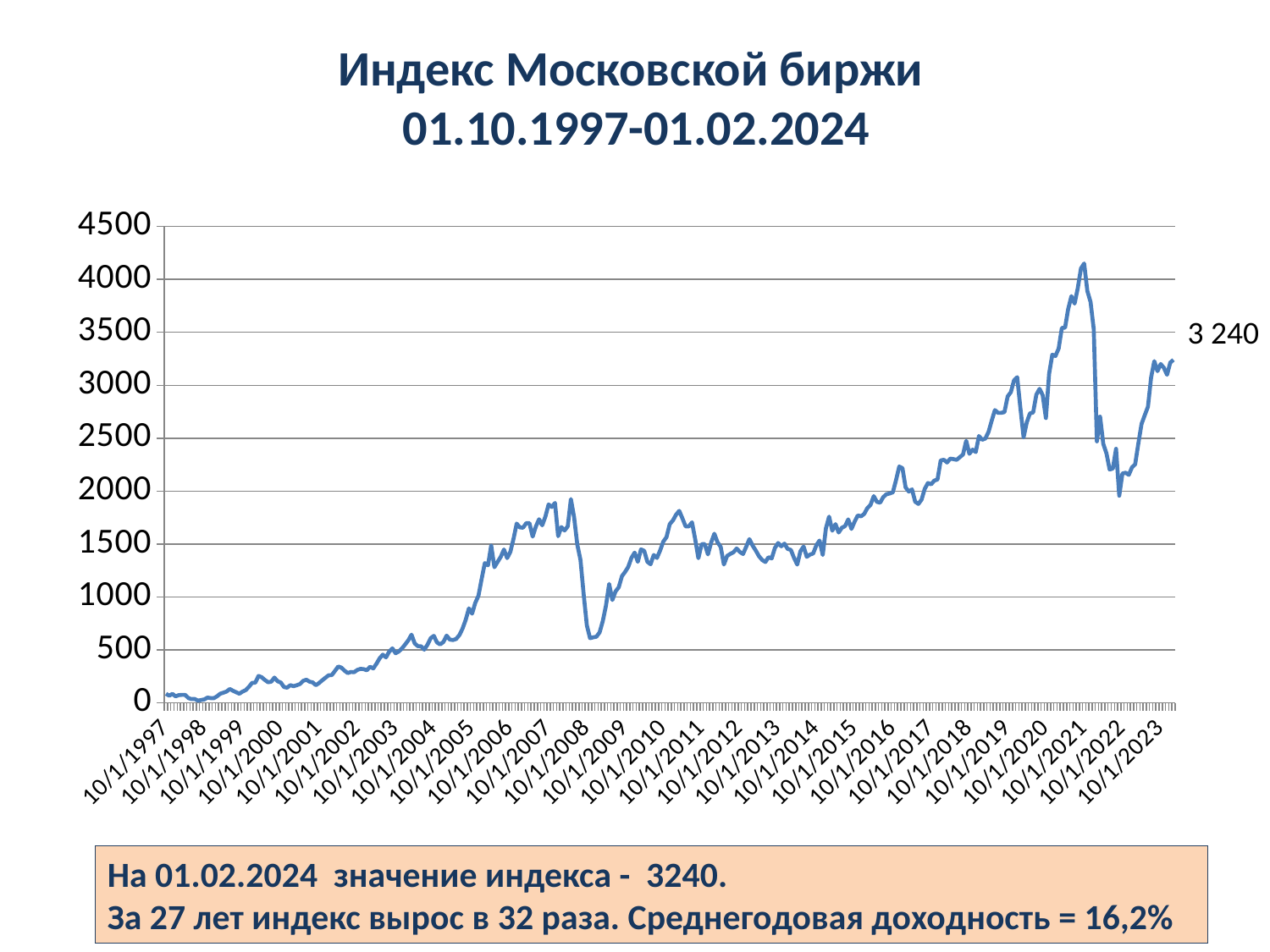
Is the value at 10/1/2021 greater or less than 3500? greater How many date labels are shown on the x axis? 27 What kind of chart is shown on the slide? line chart Overall, does the index rise or fall from 10/1/1997 to 10/1/2023? rise Which is larger, the value at 10/1/2019 or the value at 10/1/2013? 10/1/2019 Is the value at 10/1/2003 greater or less than 1000? less Around which x-axis label does the line reach its lowest point? 10/1/1998 What is the title of the chart? Индекс Московской биржи 01.10.1997-01.02.2024 What is the highest tick value shown on the y axis? 4500 How many lines (series) are plotted on the chart? 1 Around which year does the line reach its highest point? 2021 What value is printed as the data label at the end of the line? 3 240